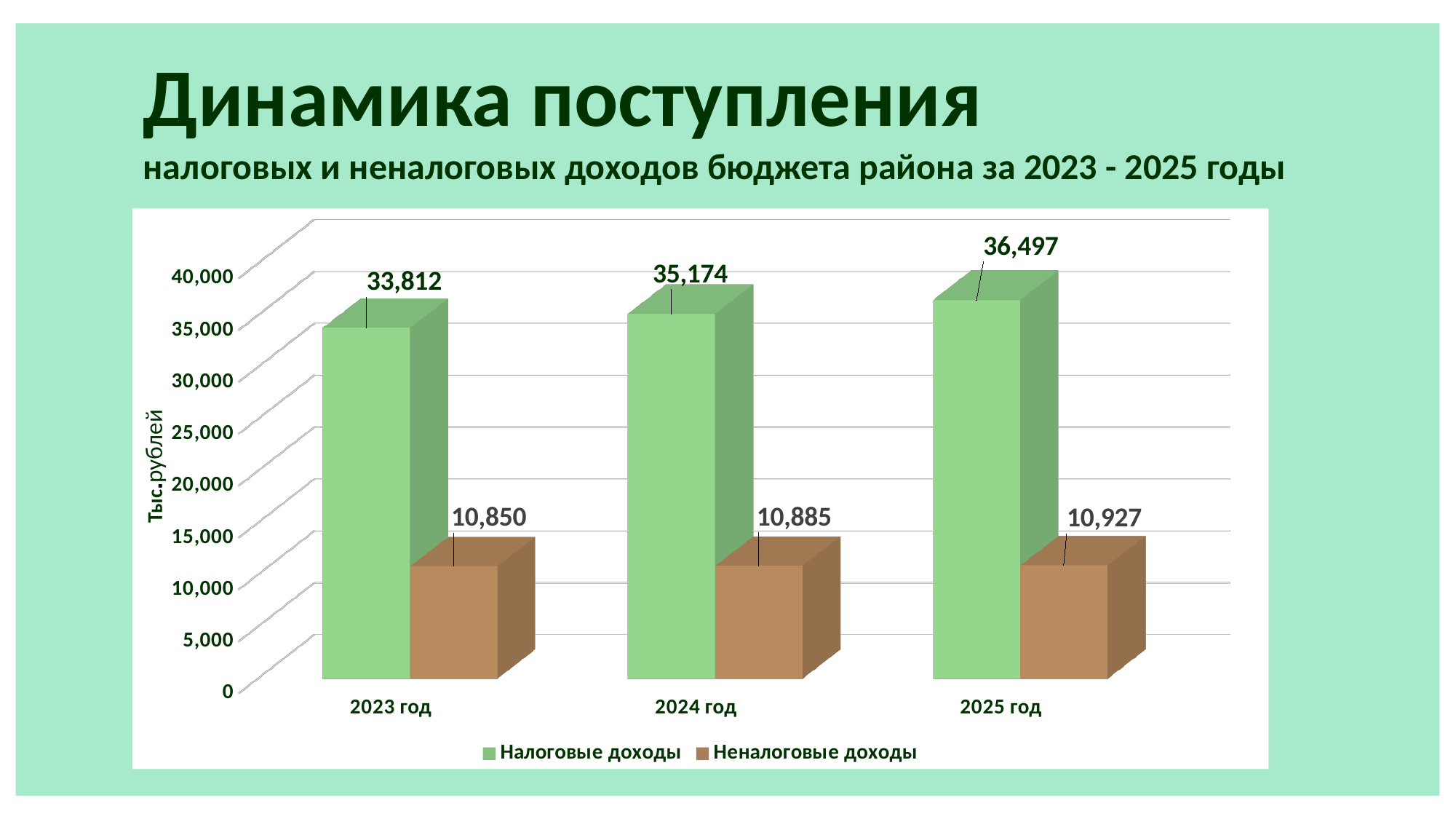
What is the value of Налоговые доходы for 2024 год? 35,174 How many series does the legend list? 2 What kind of chart is shown on the slide? Bar chart Do the values of Налоговые доходы rise or fall from 2023 год to 2025 год? Rise Which is larger in 2024 год: Налоговые доходы or Неналоговые доходы? Налоговые доходы In which year is Неналоговые доходы lowest? 2023 год In which year is Налоговые доходы highest? 2025 год How many years are shown on the x axis? 3 What is the value of Неналоговые доходы for 2025 год? 10,927 What is the value of Налоговые доходы for 2023 год? 33,812 What is the difference between Неналоговые доходы in 2024 год and 2023 год? 35 What is the difference between Налоговые доходы in 2025 год and 2023 год? 2,685